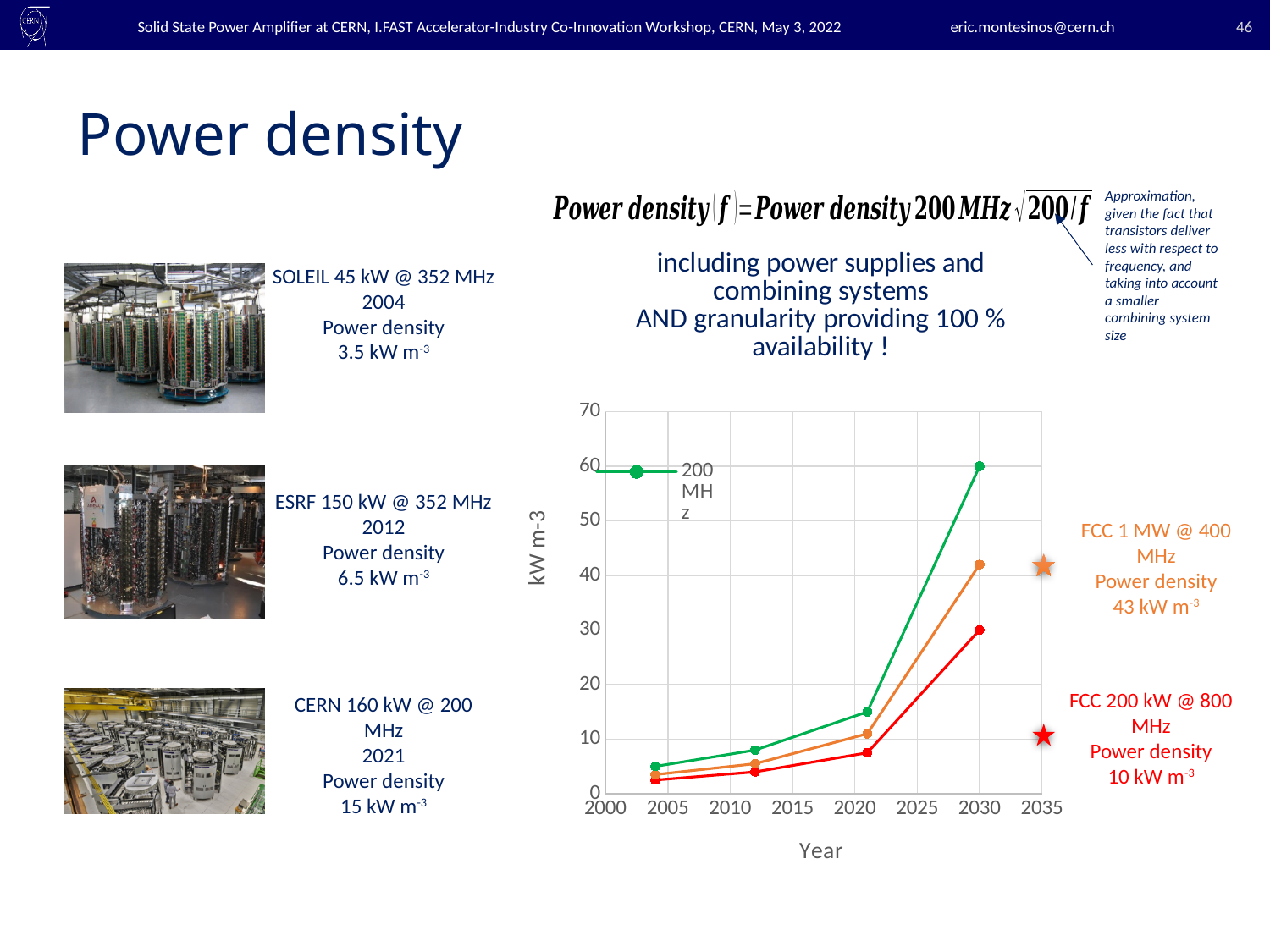
Is the value of the green line at 2021 greater or less than 10? greater Is the value of the red line at 2021 greater or less than 10? less How many data points does the green line have? 4 Is the value of the green line at 2030 greater or less than 50? greater What is the label on the y axis of the chart? kW m-3 Do the values of the green line rise or fall as the year increases? rise What is the title of the x axis of the chart? Year At 2030, which line has the larger value, the green line or the red line? green line What kind of chart is shown on the slide? line chart In which year does the green line reach its highest value? 2030